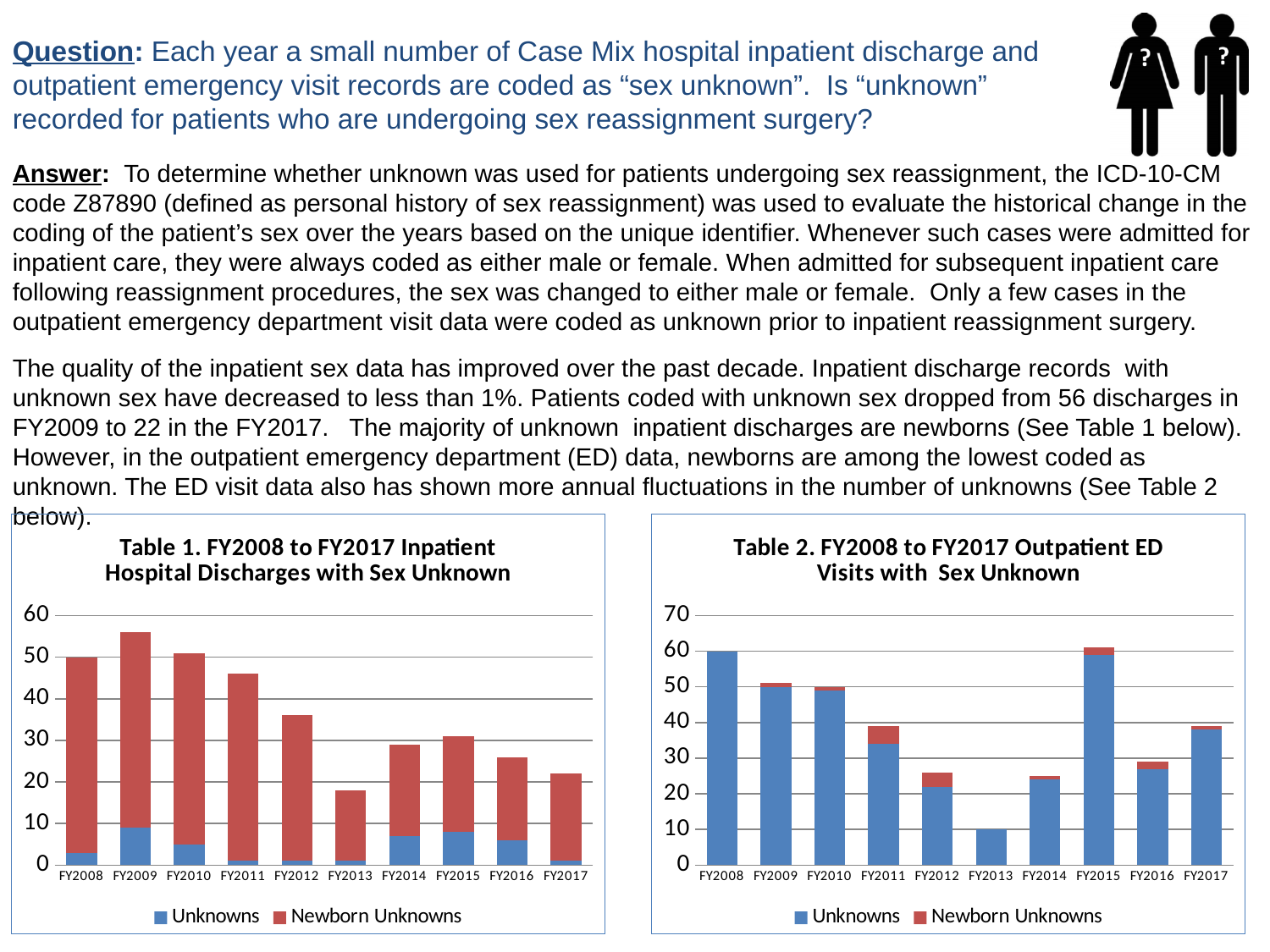
In Table 1, is the total value for FY2012 greater or less than 40? less In Table 2, is the total value for FY2015 greater or less than 50? greater In Table 1, which fiscal year has the lowest total bar? FY2013 How many series does the legend of Table 2 list? 2 In Table 1, which fiscal year has the highest total bar? FY2009 In Table 1, which is larger, the total bar for FY2010 or the total bar for FY2016? FY2010 How many fiscal years are shown on the x axis of Table 1? 10 In Table 2, what is the total value of the FY2013 bar? 10 What kind of chart is Table 1 on the left of the slide? stacked bar chart In Table 2, which series makes up most of each bar, Unknowns or Newborn Unknowns? Unknowns What is the title of the chart on the right of the slide? Table 2. FY2008 to FY2017 Outpatient ED Visits with Sex Unknown In Table 2, which fiscal year has the lowest total bar? FY2013